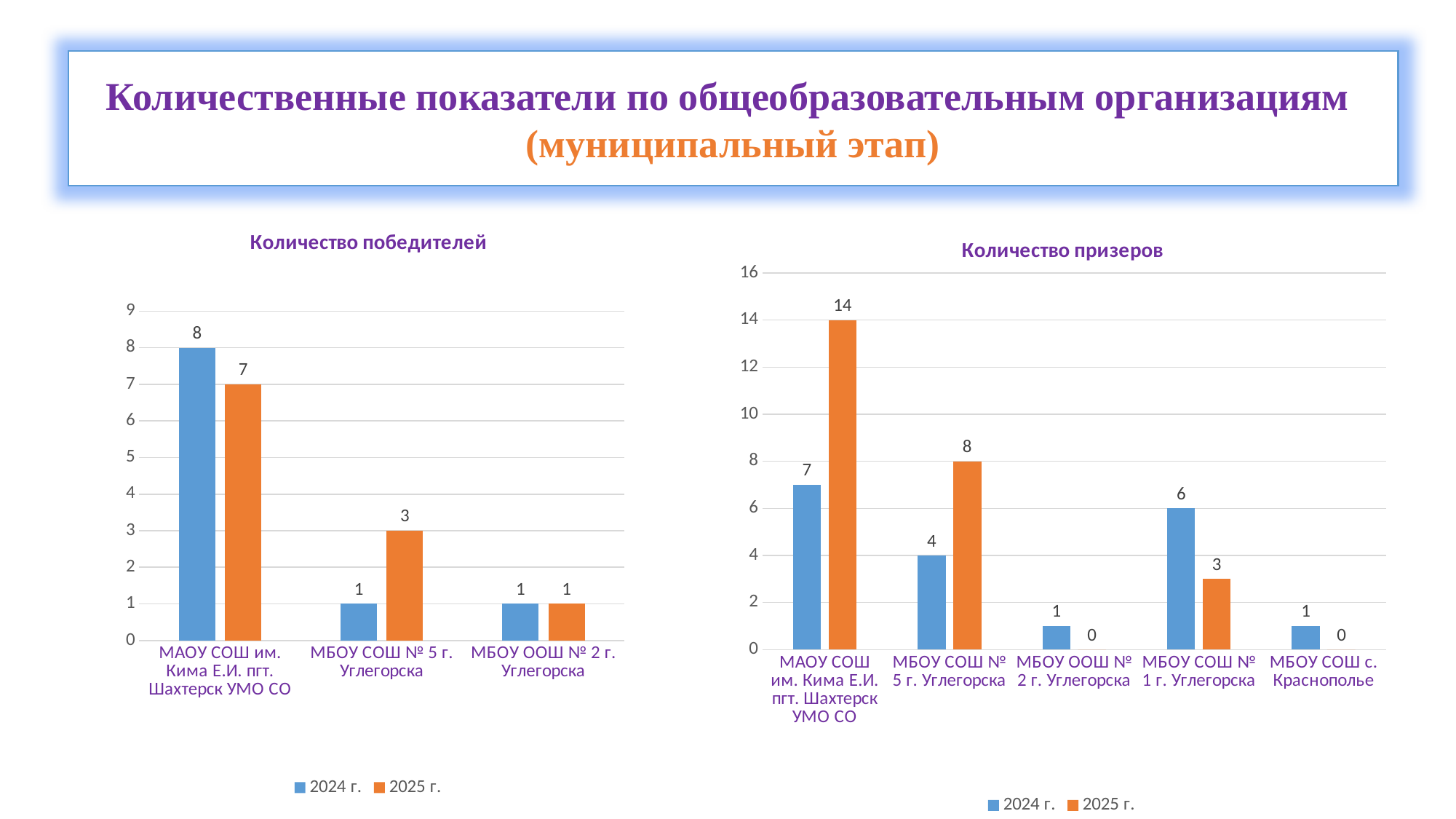
In the chart "Количество победителей", how many categories are shown on the x axis? 3 In the chart "Количество призеров", what is the difference between the 2025 г. and 2024 г. values for МБОУ СОШ № 5 г. Углегорска? 4 In the chart "Количество призеров", what is the value for МБОУ СОШ № 1 г. Углегорска in 2025 г.? 3 In the chart "Количество победителей", what is the value for МАОУ СОШ им. Кима Е.И. пгт. Шахтерск УМО СО in 2024 г.? 8 In the chart "Количество призеров", what is the value for МАОУ СОШ им. Кима Е.И. пгт. Шахтерск УМО СО in 2025 г.? 14 In the chart "Количество победителей", what is the difference between the 2024 г. and 2025 г. values for МАОУ СОШ им. Кима Е.И. пгт. Шахтерск УМО СО? 1 In the chart "Количество призеров", how many categories are shown on the x axis? 5 What type of chart is "Количество победителей"? Bar chart In the chart "Количество призеров", which is larger for МБОУ СОШ № 1 г. Углегорска: the 2024 г. value or the 2025 г. value? 2024 г. How many series does the legend of the chart "Количество призеров" list? 2 In the chart "Количество победителей", what is the value for МБОУ СОШ № 5 г. Углегорска in 2025 г.? 3 In the chart "Количество призеров", which category has the highest 2024 г. value? МАОУ СОШ им. Кима Е.И. пгт. Шахтерск УМО СО